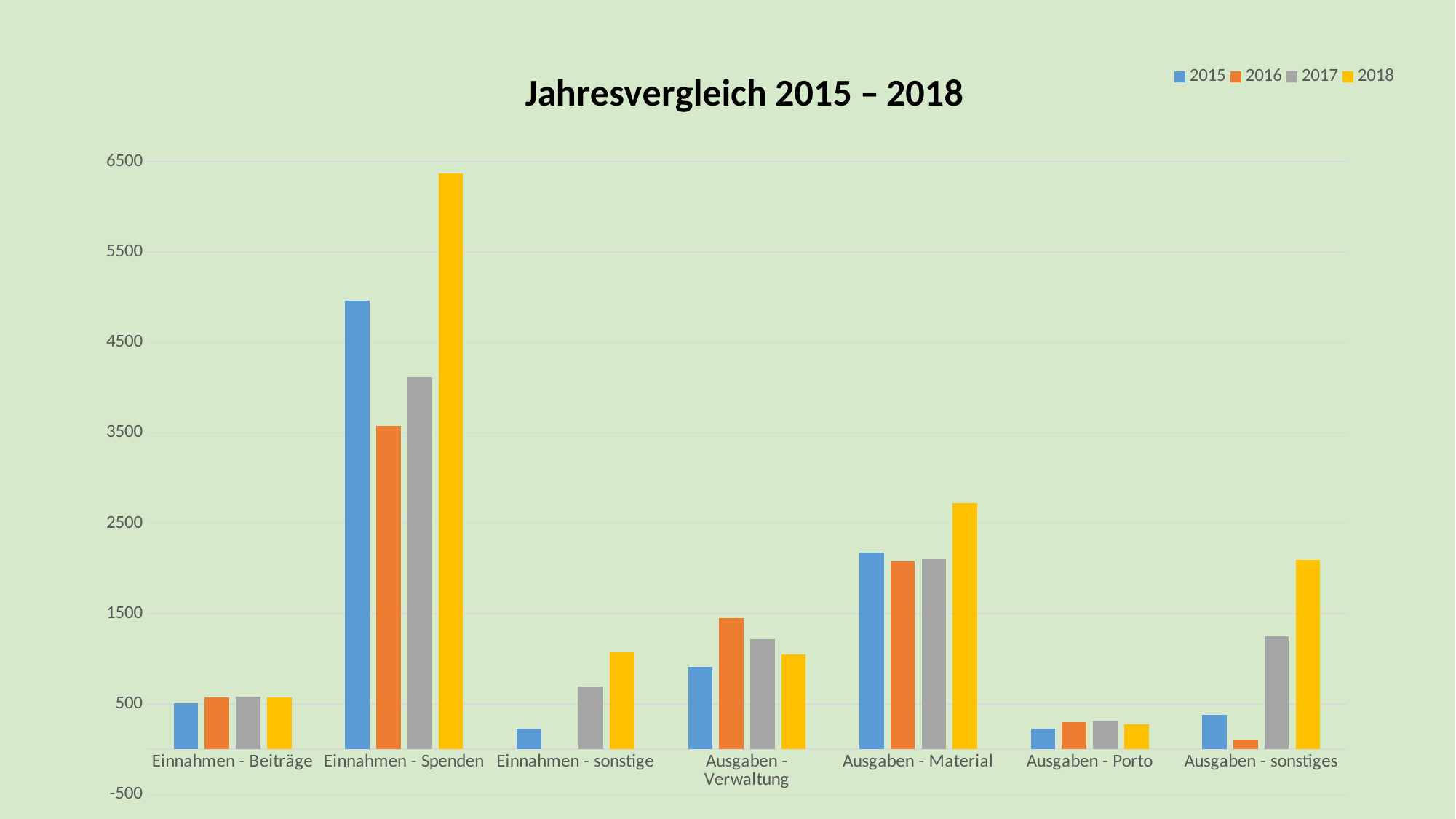
Within Einnahmen - Spenden, which year has the highest value? 2018 How many categories are shown on the x axis? 7 What kind of chart is shown on the slide? bar chart What is the title of the chart? Jahresvergleich 2015 – 2018 How many series does the legend list? 4 For Ausgaben - Verwaltung, which year has the larger value, 2016 or 2018? 2016 Is the value for 2017 in Einnahmen - Spenden greater or less than 4500? less Is the value for 2018 in Ausgaben - Material greater or less than 2500? greater Which category has the highest bar in the chart? Einnahmen - Spenden Within Einnahmen - Spenden, which year has the lowest value? 2016 Within Ausgaben - sonstiges, which year has the lowest value? 2016 Is the value for 2018 in Einnahmen - Spenden greater or less than 5500? greater